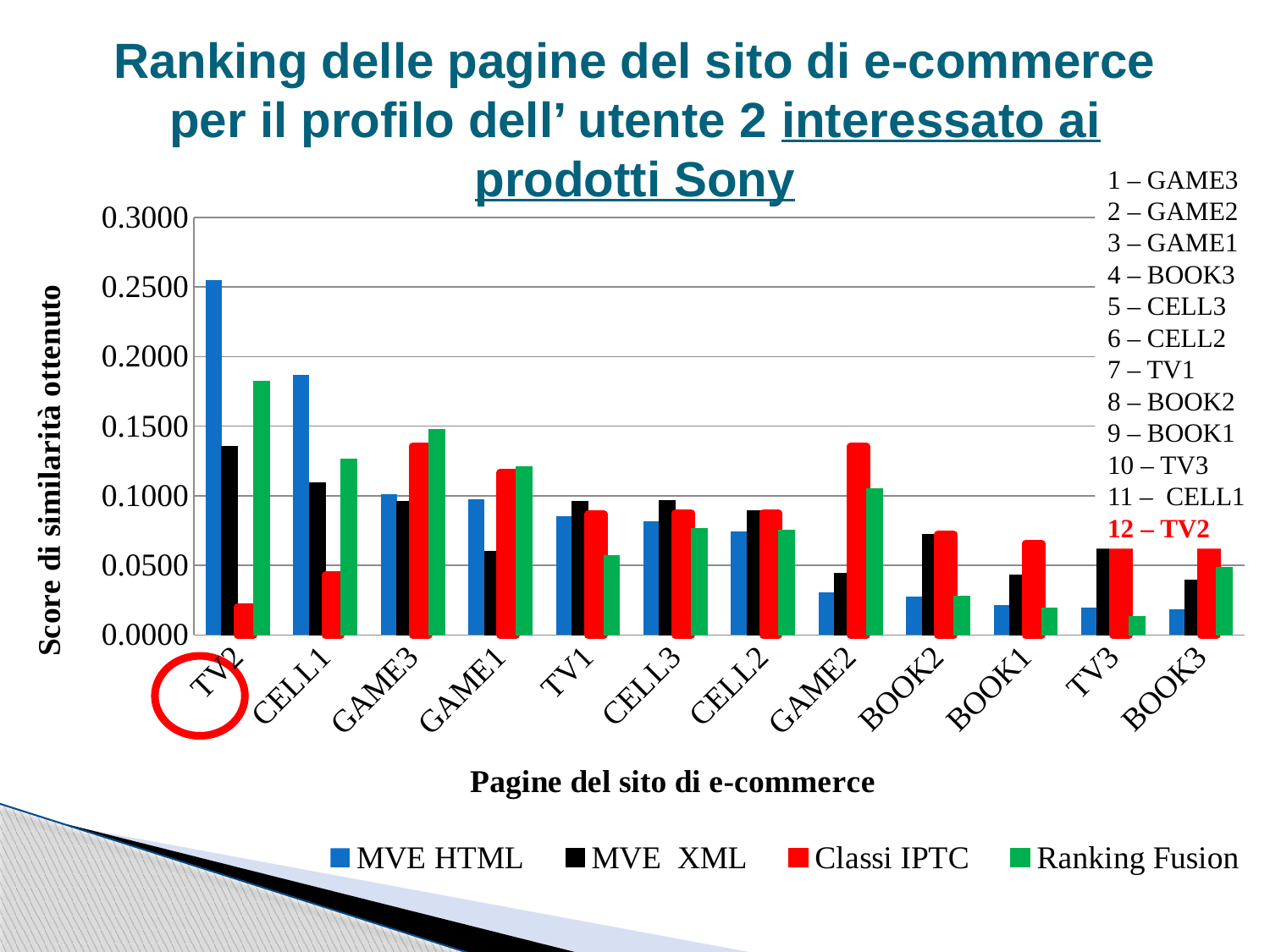
Do the MVE HTML values generally rise or fall moving from left to right along the x axis? fall How many pages (categories) are shown on the x axis of the chart? 12 Is the MVE HTML value for TV2 greater or less than 0.2000? greater Is the Classi IPTC value for TV2 greater or less than 0.0500? less For which page is the MVE HTML value highest? TV2 For which page is the Ranking Fusion value highest? TV2 What kind of chart is shown on the slide? bar chart Is the Classi IPTC value for GAME2 greater or less than 0.1000? greater What is the title of the chart's vertical axis? Score di similarità ottenuto How many series does the chart legend list? 4 For GAME2, which is larger, the MVE HTML value or the Classi IPTC value? Classi IPTC Which is larger, the Ranking Fusion value for TV2 or for CELL1? TV2